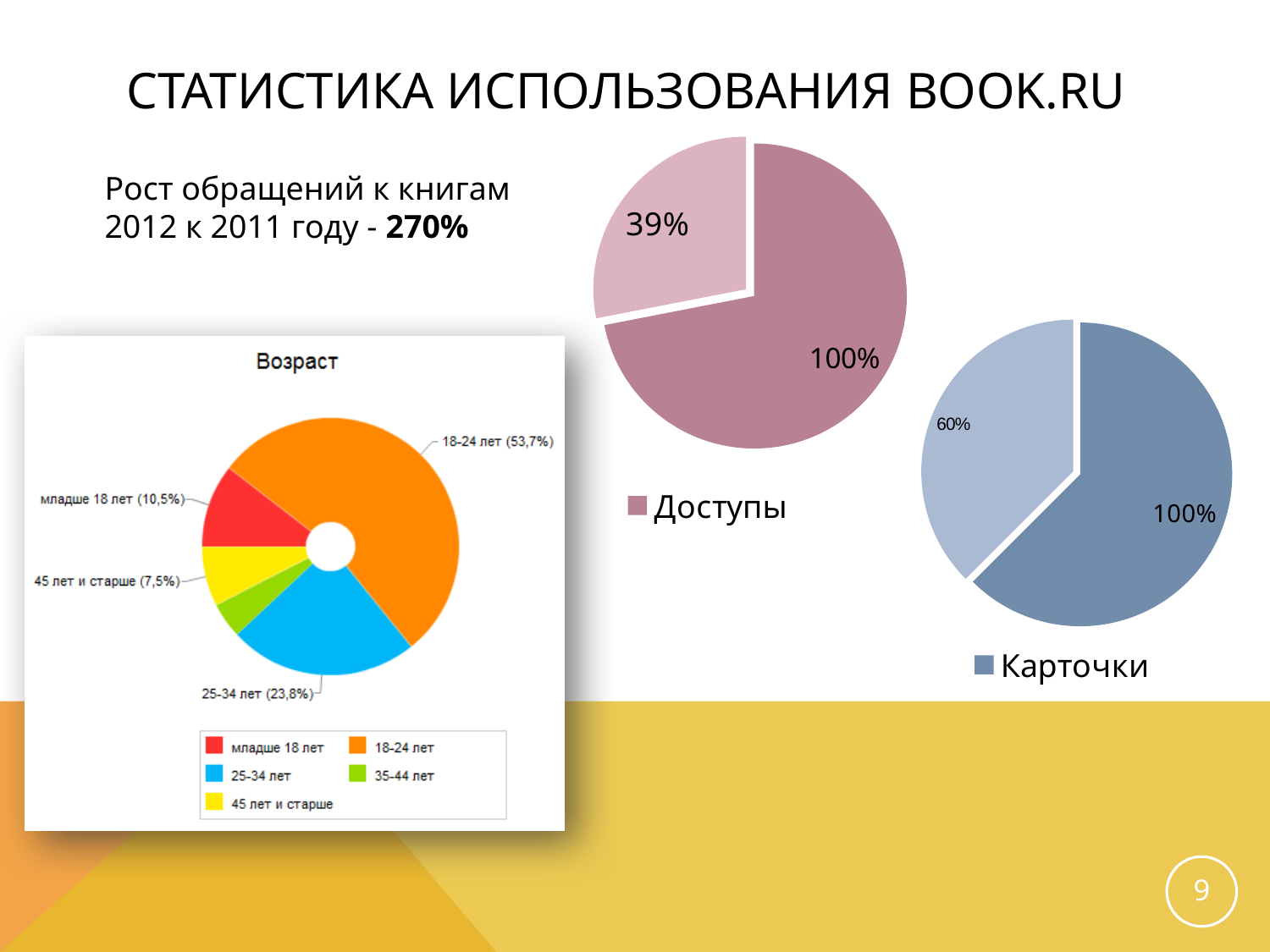
On the "Возраст" chart, what share is shown for the 45 лет и старше category? 7,5% On the "Доступы" pie chart, what value is shown on the smaller slice? 39% On the "Возраст" chart, which is larger: the share of младше 18 лет or 45 лет и старше? младше 18 лет On the "Возраст" chart, what colour represents the 18-24 лет category? Orange On the "Возраст" chart, what share is shown for the 18-24 лет category? 53,7% On the "Карточки" pie chart, what value is shown on the smaller slice? 60% On the "Возраст" chart, which age group has the largest share? 18-24 лет On the "Возраст" chart, what share is shown for the младше 18 лет category? 10,5% On the "Возраст" chart, how many age categories does the legend list? 5 On the "Возраст" chart, what share is shown for the 25-34 лет category? 23,8% On the "Возраст" chart, what is the difference between the shares of 18-24 лет and 25-34 лет? 29,9% What type of chart is the "Возраст" chart? Pie (donut) chart